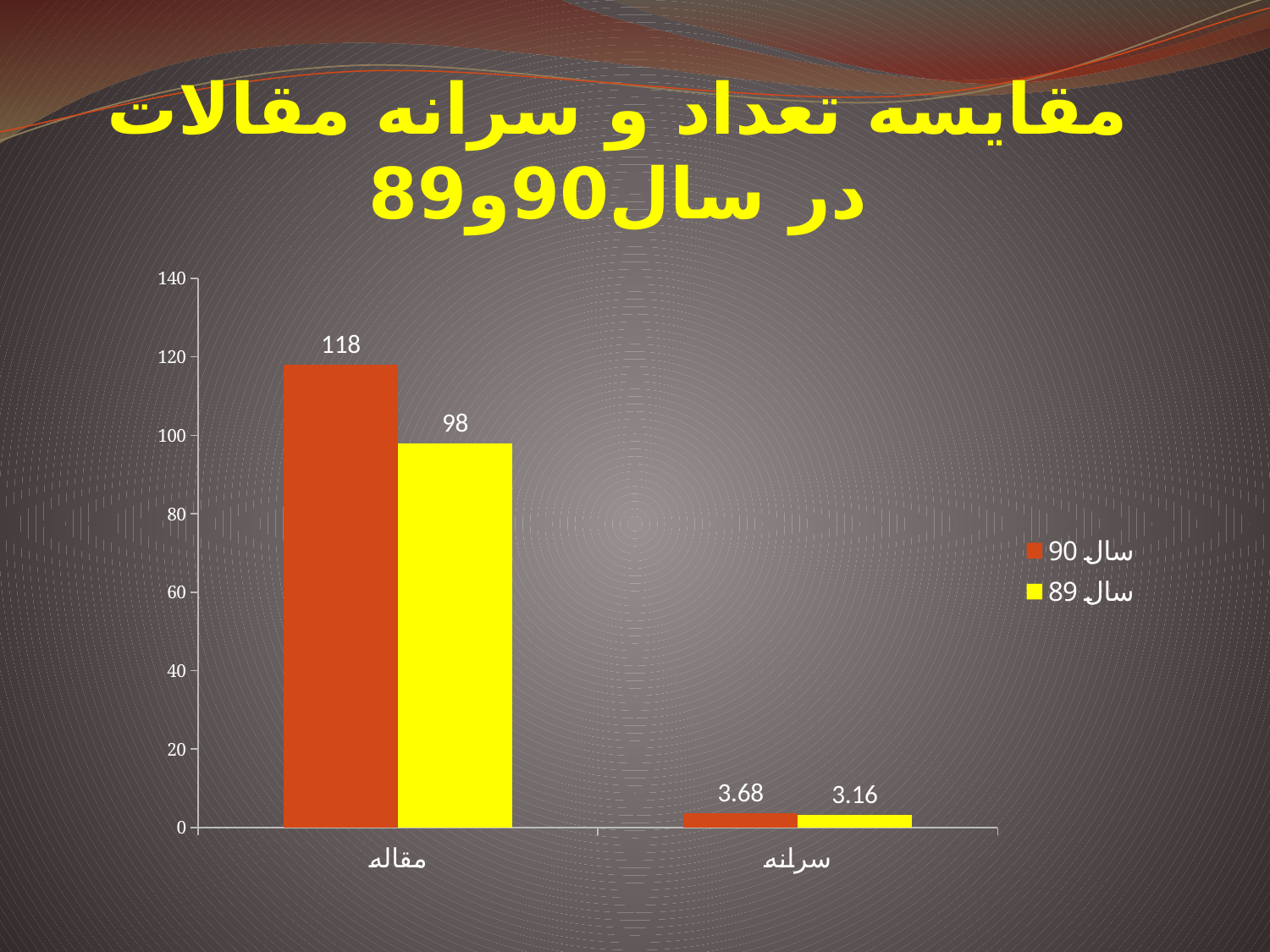
What is the difference between the سال 90 and سال 89 values in the سرانه category? 0.52 How many categories are shown on the x axis? 2 What is the value for سال 90 in the سرانه category? 3.68 What kind of chart is shown on the slide? bar chart What is the value for سال 90 in the مقاله category? 118 What is the difference between the سال 90 and سال 89 values in the مقاله category? 20 Which series has the larger value in the مقاله category, سال 90 or سال 89? سال 90 How many series does the legend list? 2 What is the value for سال 89 in the سرانه category? 3.16 Which category has the highest bar on the chart? مقاله What is the value for سال 89 in the مقاله category? 98 Is the value for سال 89 in the مقاله category greater or less than 100? less